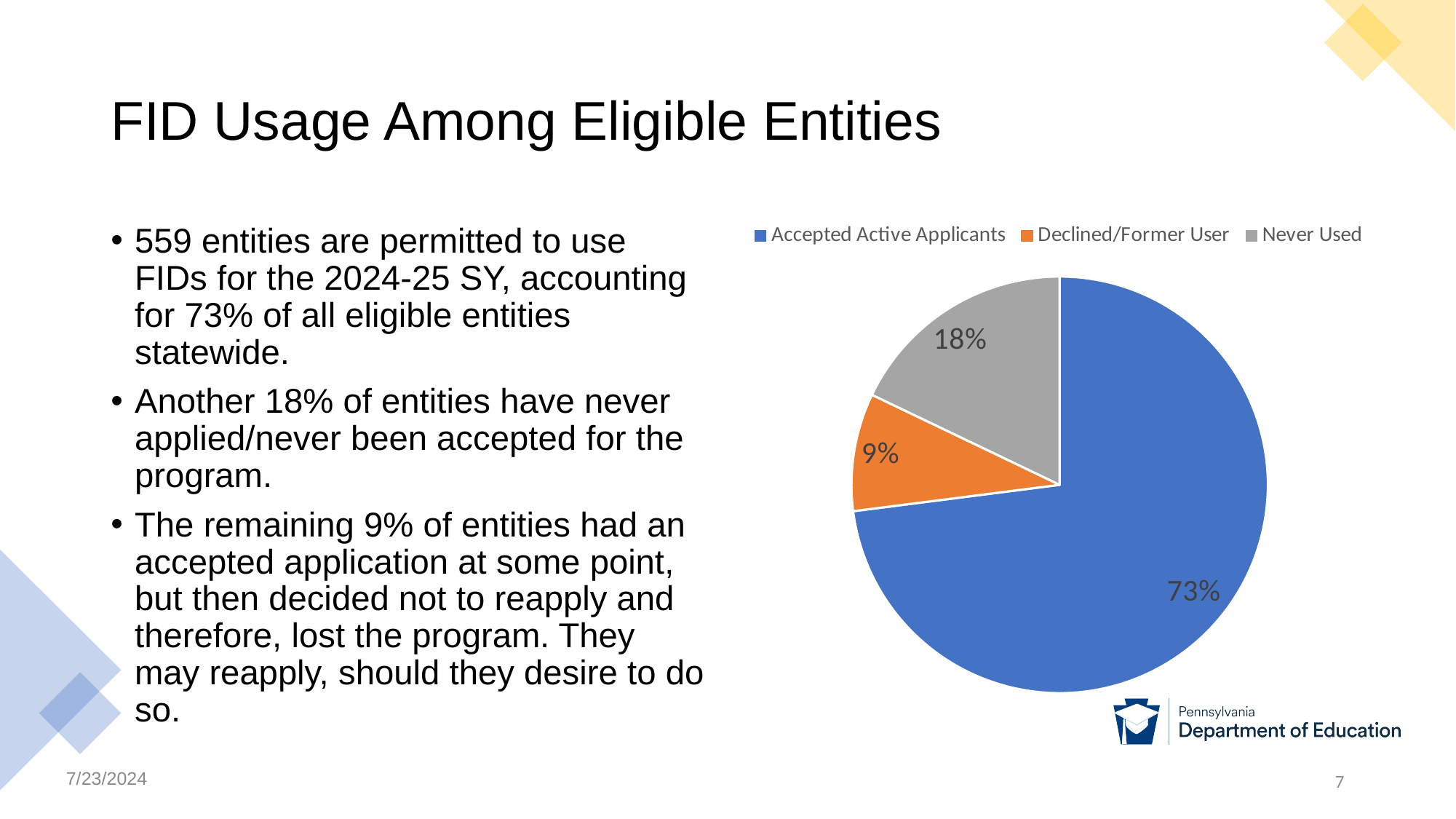
What share of the pie is Declined/Former User? 9% What kind of chart is shown on the slide? pie chart Which is larger, the Never Used slice or the Declined/Former User slice? Never Used Which category has the largest slice of the pie? Accepted Active Applicants How many categories does the pie chart show? 3 What colour is the Declined/Former User slice? orange What share of the pie is Accepted Active Applicants? 73% How many entries does the legend list? 3 What colour is the Never Used slice? gray What is the difference in percentage points between Never Used and Declined/Former User? 9 Which category has the smallest slice of the pie? Declined/Former User What share of the pie is Never Used? 18%